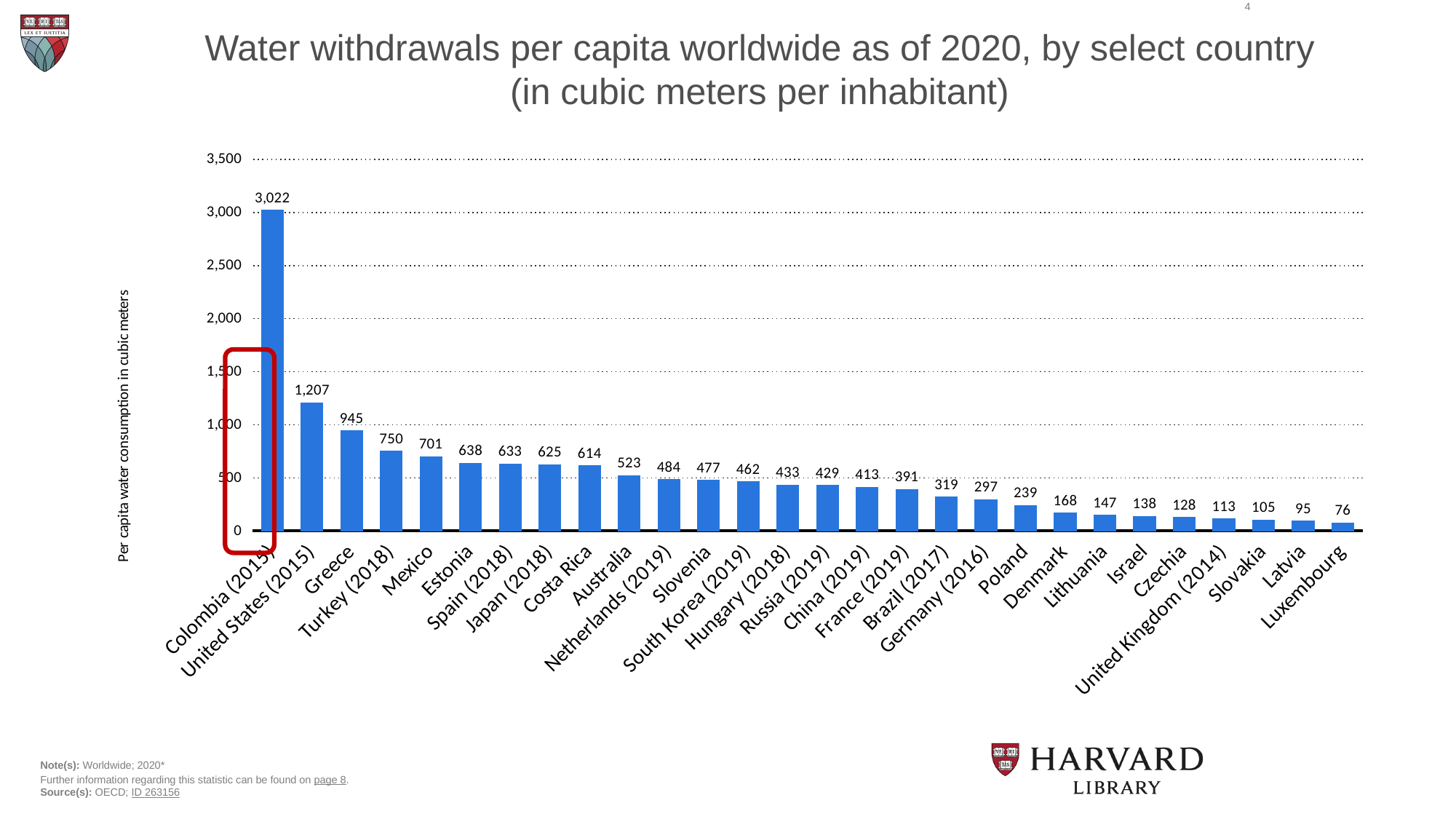
Which has a larger value, Mexico or Estonia? Mexico Do the values rise or fall from left to right along the x axis? Fall How many countries are shown in the chart? 28 What is the difference between the values for the United States (2015) and Greece? 262 What kind of chart is shown on the slide? Bar chart Which country has the lowest water withdrawal per capita? Luxembourg What is the value shown for Germany (2016)? 297 What is the water withdrawal per capita value for Colombia (2015)? 3,022 What is the label of the vertical axis? Per capita water consumption in cubic meters What is the value shown for Greece? 945 What is the value shown for Japan (2018)? 625 Which country has the highest water withdrawal per capita? Colombia (2015)